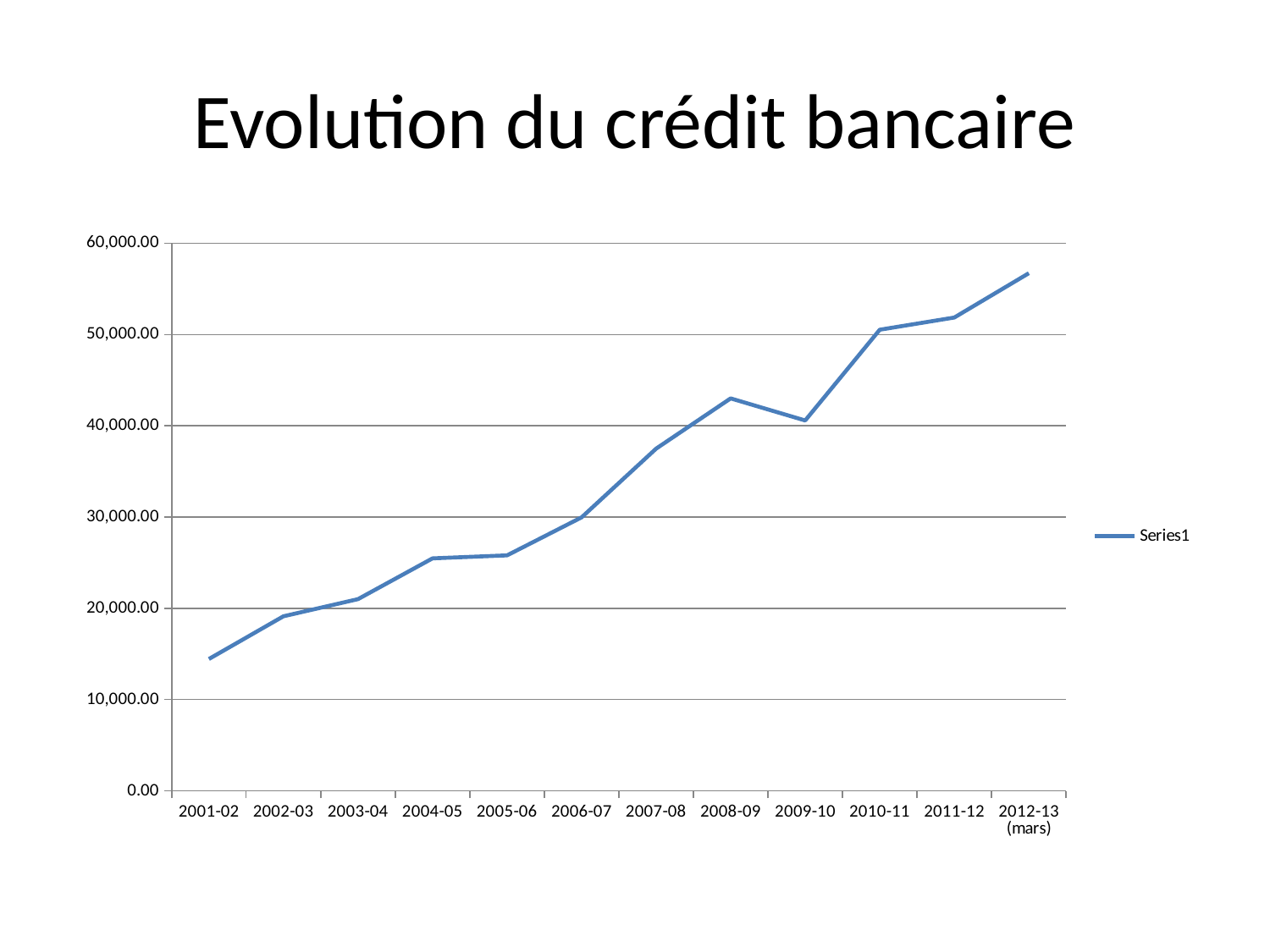
What is the name of the series shown in the legend? Series1 Which period has the highest value? 2012-13 (mars) Is the value for 2001-02 greater or less than 20,000.00? less What is the title of the chart? Evolution du crédit bancaire How many periods are plotted along the x axis? 12 Is the value for 2012-13 (mars) greater or less than 50,000.00? greater Is the value for 2008-09 greater or less than 40,000.00? greater Which is larger, the value for 2008-09 or the value for 2009-10? 2008-09 Overall, do the values rise or fall from 2001-02 to 2012-13 (mars)? Rise How many series does the legend list? 1 What kind of chart is shown on the slide? Line chart Which period has the lowest value? 2001-02